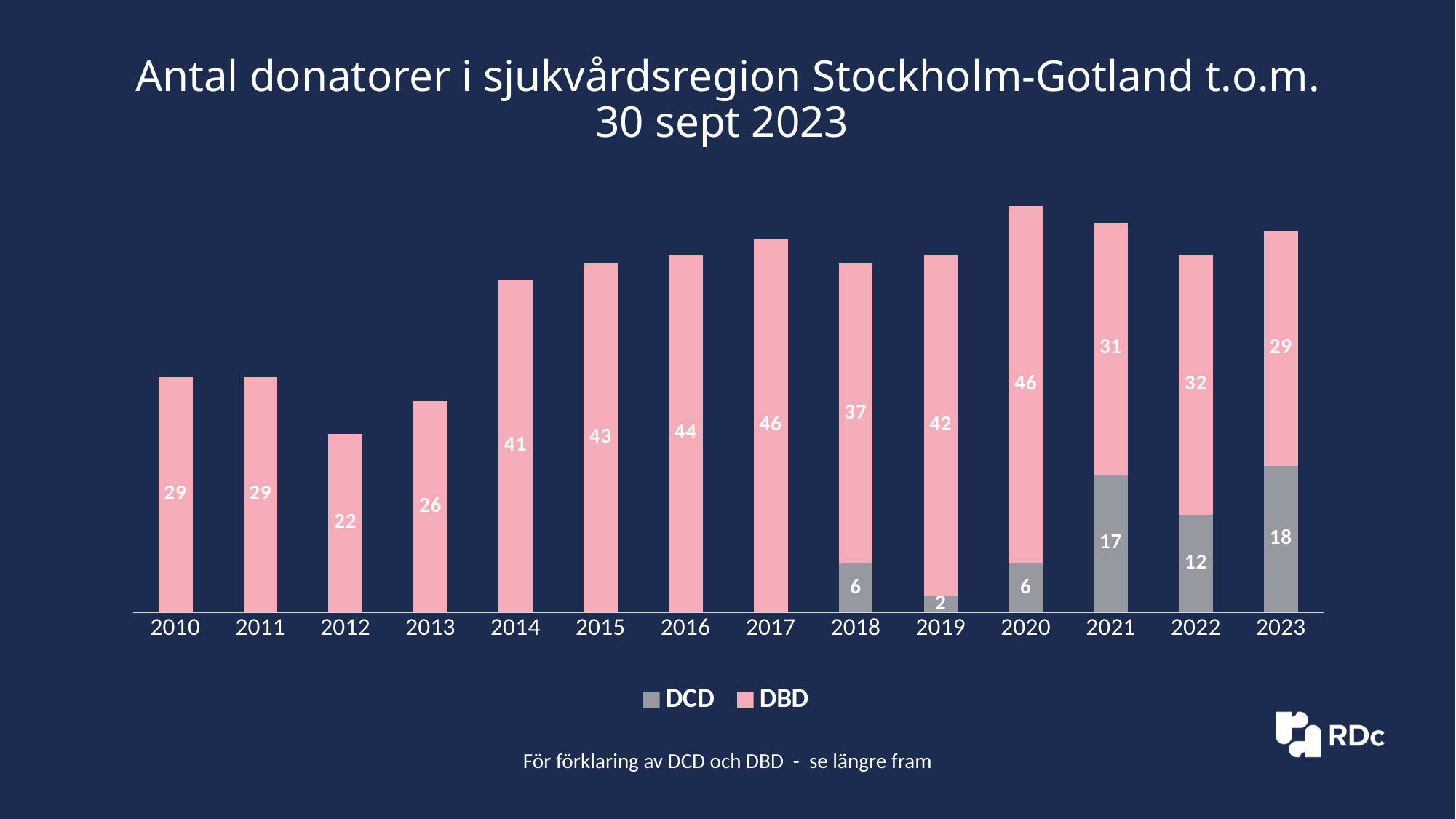
Which is larger, the DCD value for 2022 or the DCD value for 2023? 2023 Which year has the tallest bar overall? 2020 What type of chart is shown on the slide? stacked bar chart How many series does the legend list? 2 How many years are shown on the x axis? 14 Which colour represents DCD in the legend? grey What is the DBD value for 2014? 41 Which year has the highest DCD value? 2023 What is the total number of donors (DCD plus DBD) in 2020? 52 What is the difference between the DBD values for 2017 and 2018? 9 Which year has the lowest DBD value? 2012 What is the DCD value for 2021? 17